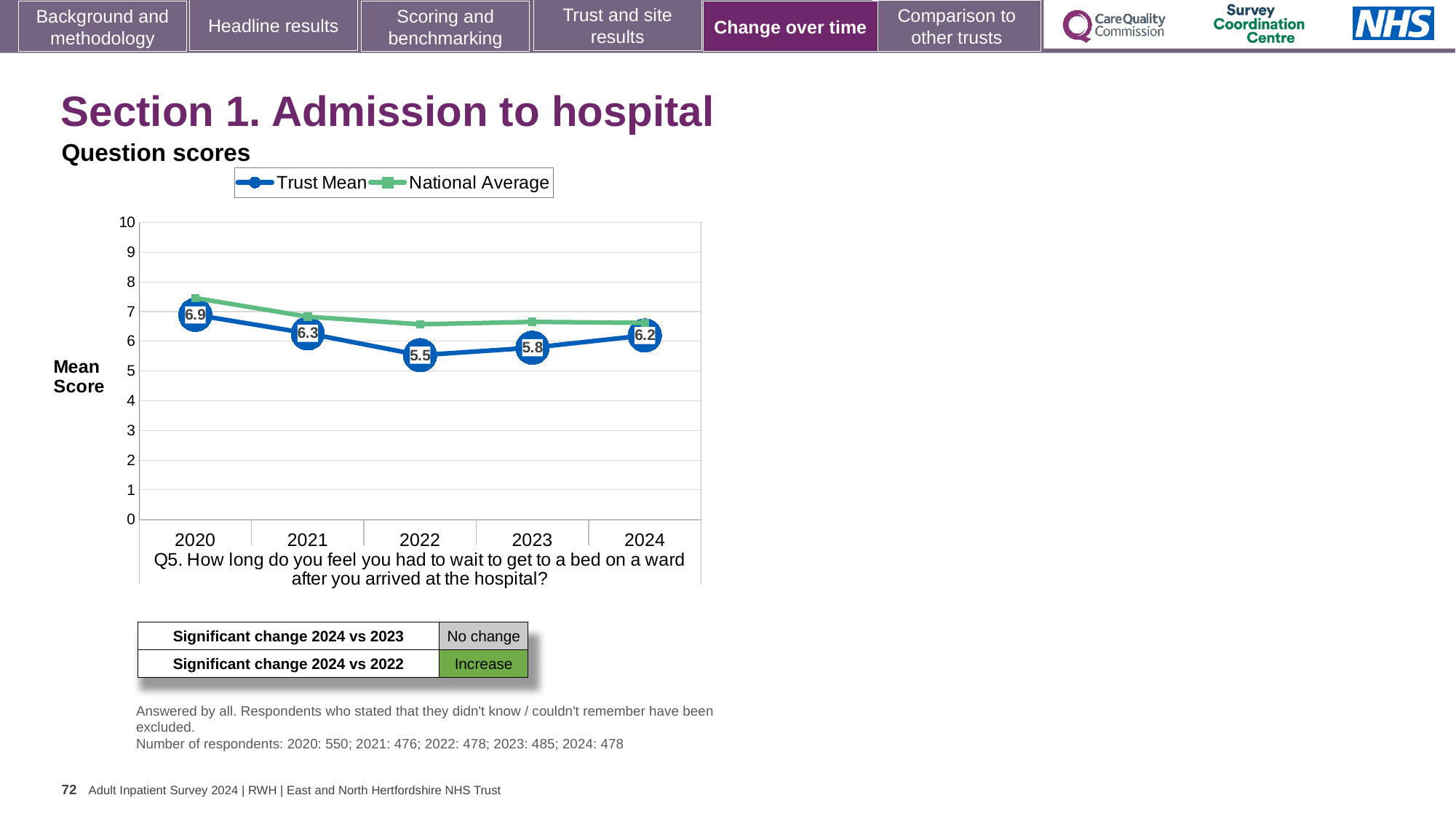
What is the Trust Mean score for 2024? 6.2 What is the difference between the Trust Mean scores for 2020 and 2022? 1.4 What is the Trust Mean score for 2022? 5.5 How many years are shown on the x axis? 5 How many series does the legend list? 2 Is the National Average for 2020 greater or less than 7? greater Which is larger, the Trust Mean score for 2021 or for 2023? 2021 In which year is the Trust Mean score lowest? 2022 Does the Trust Mean score rise or fall from 2020 to 2022? fall What kind of chart is shown? line chart In which year is the Trust Mean score highest? 2020 What is the Trust Mean score for 2020? 6.9